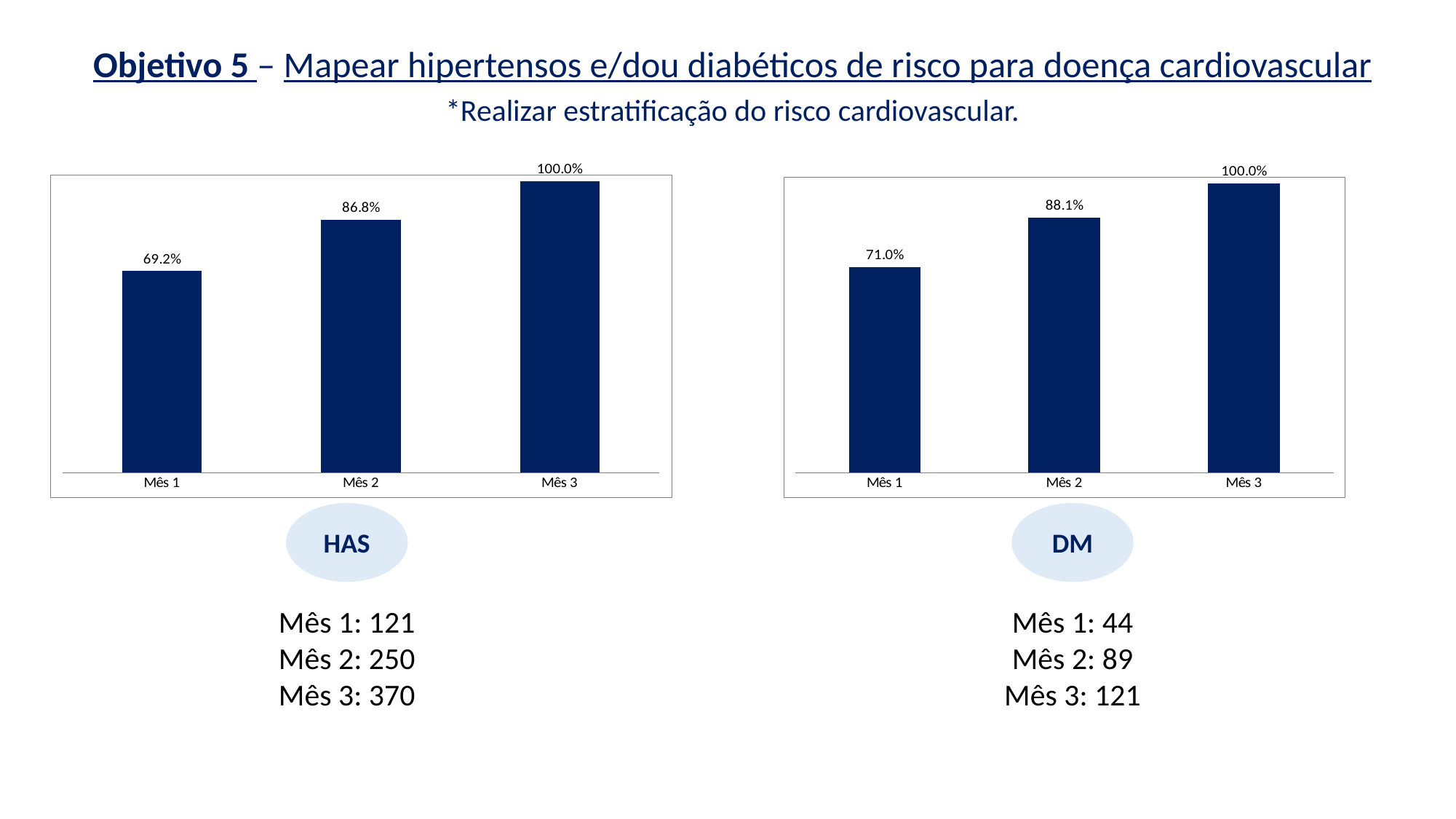
In the DM chart (right), what is the value for Mês 1? 71.0% In the HAS chart (left), what is the value for Mês 1? 69.2% In the DM chart (right), what is the value for Mês 2? 88.1% In the HAS chart (left), what is the value for Mês 2? 86.8% What type of chart is the DM chart (right)? Bar chart In the HAS chart (left), what is the difference between Mês 3 and Mês 1? 30.8% In the DM chart (right), which month has the highest value? Mês 3 Which is larger: Mês 1 in the HAS chart or Mês 1 in the DM chart? Mês 1 in the DM chart In the DM chart (right), what is the difference between Mês 2 and Mês 1? 17.1% In the HAS chart (left), which month has the lowest value? Mês 1 How many bars does the HAS chart (left) have? 3 In the HAS chart (left), do the values rise or fall from Mês 1 to Mês 3? Rise